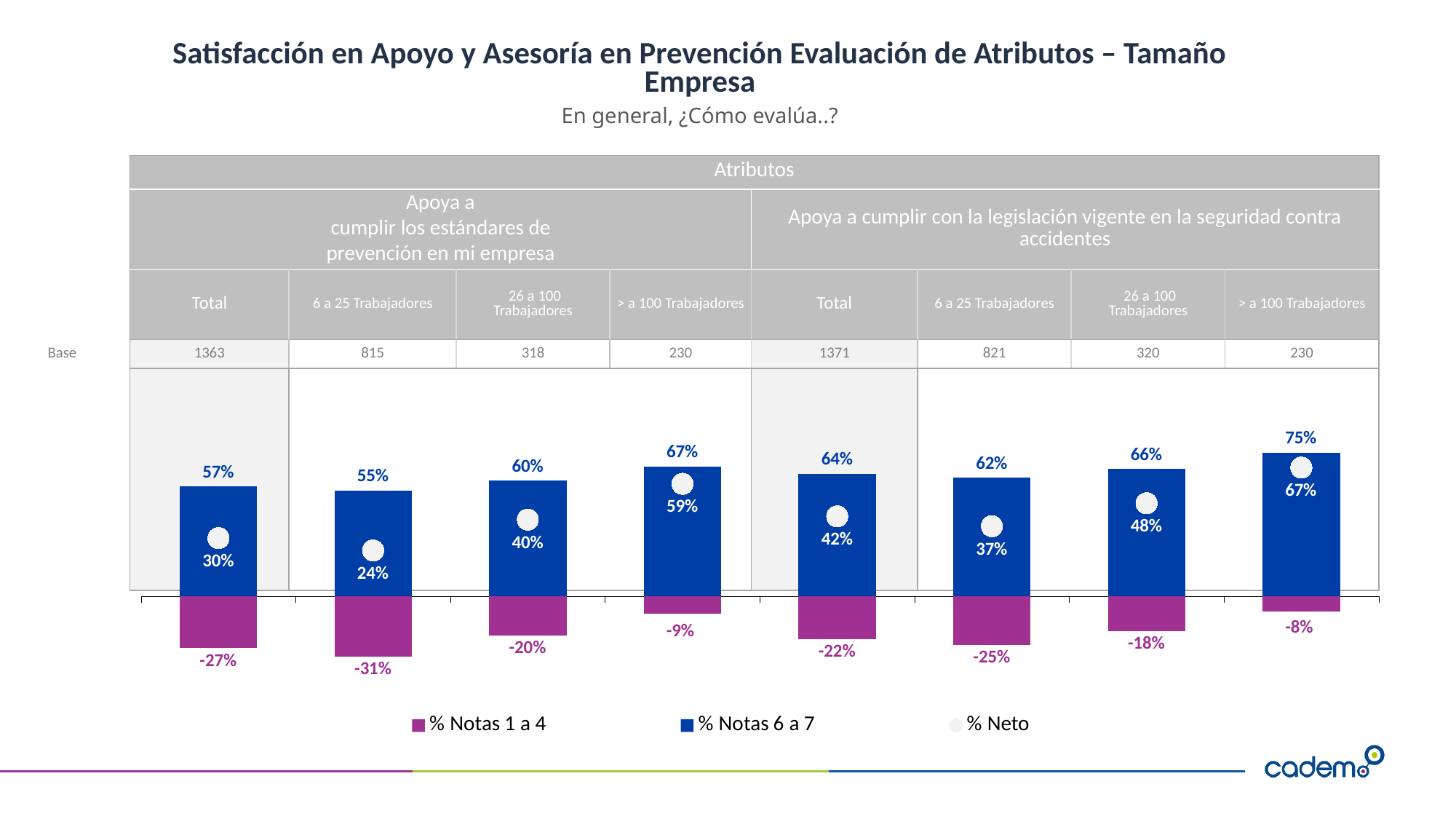
What is the % Notas 6 a 7 value for Total under "Apoya a cumplir los estándares de prevención en mi empresa"? 57% What is the difference between the % Notas 6 a 7 values for the two Total columns (64% and 57%)? 7 percentage points Which category has the highest % Notas 6 a 7 value on the chart? > a 100 Trabajadores (Apoya a cumplir con la legislación vigente en la seguridad contra accidentes) What kind of chart is shown on the slide? Combination bar and line chart (stacked bars with % Neto shown as circle markers) What is the % Notas 1 a 4 value for "6 a 25 Trabajadores" under "Apoya a cumplir los estándares de prevención en mi empresa"? -31% Which category has the lowest % Neto value on the chart? 6 a 25 Trabajadores (Apoya a cumplir los estándares de prevención en mi empresa) How many category columns are plotted on the chart? 8 How many series does the legend list? 3 What is the % Neto value for "> a 100 Trabajadores" under "Apoya a cumplir con la legislación vigente en la seguridad contra accidentes"? 67% Within "Apoya a cumplir con la legislación vigente en la seguridad contra accidentes", do the % Notas 6 a 7 values rise or fall from "6 a 25 Trabajadores" to "> a 100 Trabajadores"? Rise What is the Base for Total under "Apoya a cumplir con la legislación vigente en la seguridad contra accidentes"? 1371 Which is larger: the % Neto for "26 a 100 Trabajadores" under the first attribute or under the second attribute? Second attribute (48%)